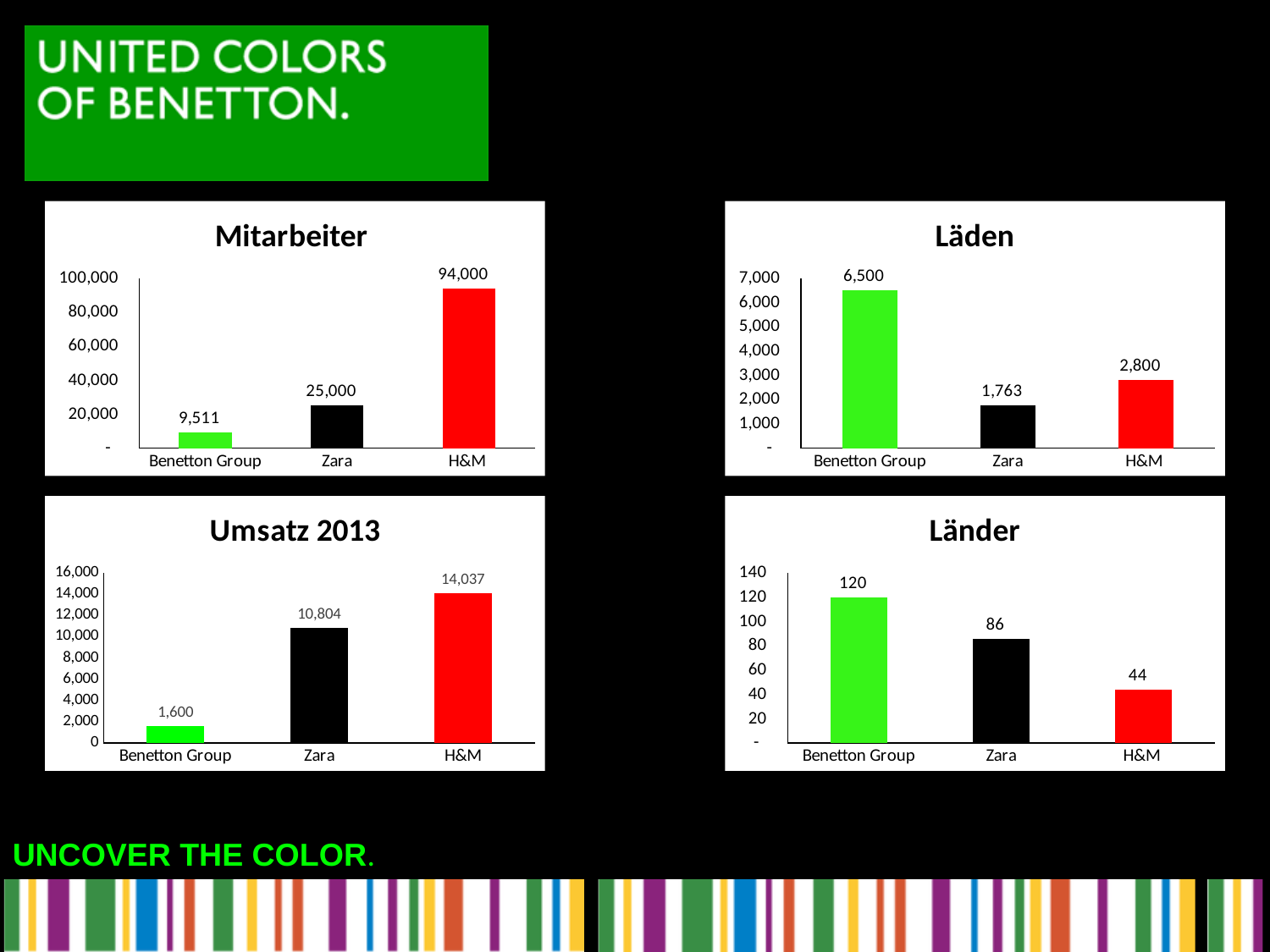
In the Mitarbeiter chart, which company has the lowest value? Benetton Group In the Länder chart, do the values rise or fall from left to right? fall In the Umsatz 2013 chart, which is larger, the value for Zara or the value for H&M? H&M How many categories does the Mitarbeiter chart show? 3 In the Läden chart, which company has the highest value? Benetton Group In the Umsatz 2013 chart, what is the value for Zara? 10,804 In the Läden chart, what is the value for Zara? 1,763 What kind of chart is the Umsatz 2013 chart? bar chart In the Mitarbeiter chart, what is the value for H&M? 94,000 In the Länder chart, what is the value for Benetton Group? 120 In the Läden chart, what is the difference between Benetton Group and H&M? 3,700 In the Länder chart, what is the difference between Zara and H&M? 42